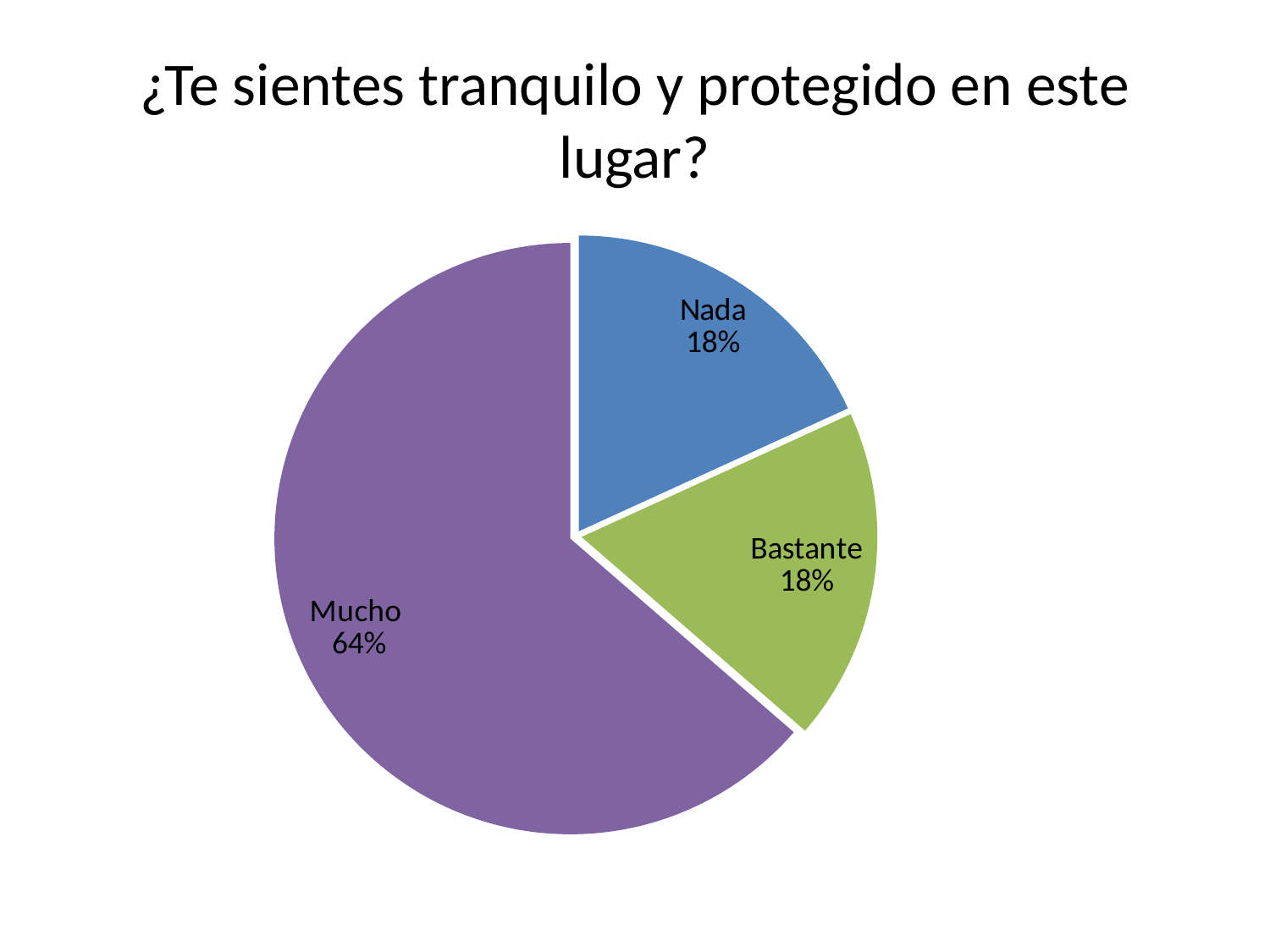
What is the difference in percentage points between the Mucho slice and the Nada slice? 46 What share of the pie does the Nada slice represent? 18% What kind of chart is shown on the slide? pie chart Which category has the largest slice of the pie? Mucho Do the Nada and Bastante slices have the same percentage? Yes What is the title of the chart? ¿Te sientes tranquilo y protegido en este lugar? What share of the pie does the Mucho slice represent? 64% What is the combined share of the Nada and Bastante slices? 36% What share of the pie does the Bastante slice represent? 18% What colour is the Mucho slice? purple Which is larger, the Mucho slice or the Bastante slice? Mucho How many slices does the pie chart have? 3